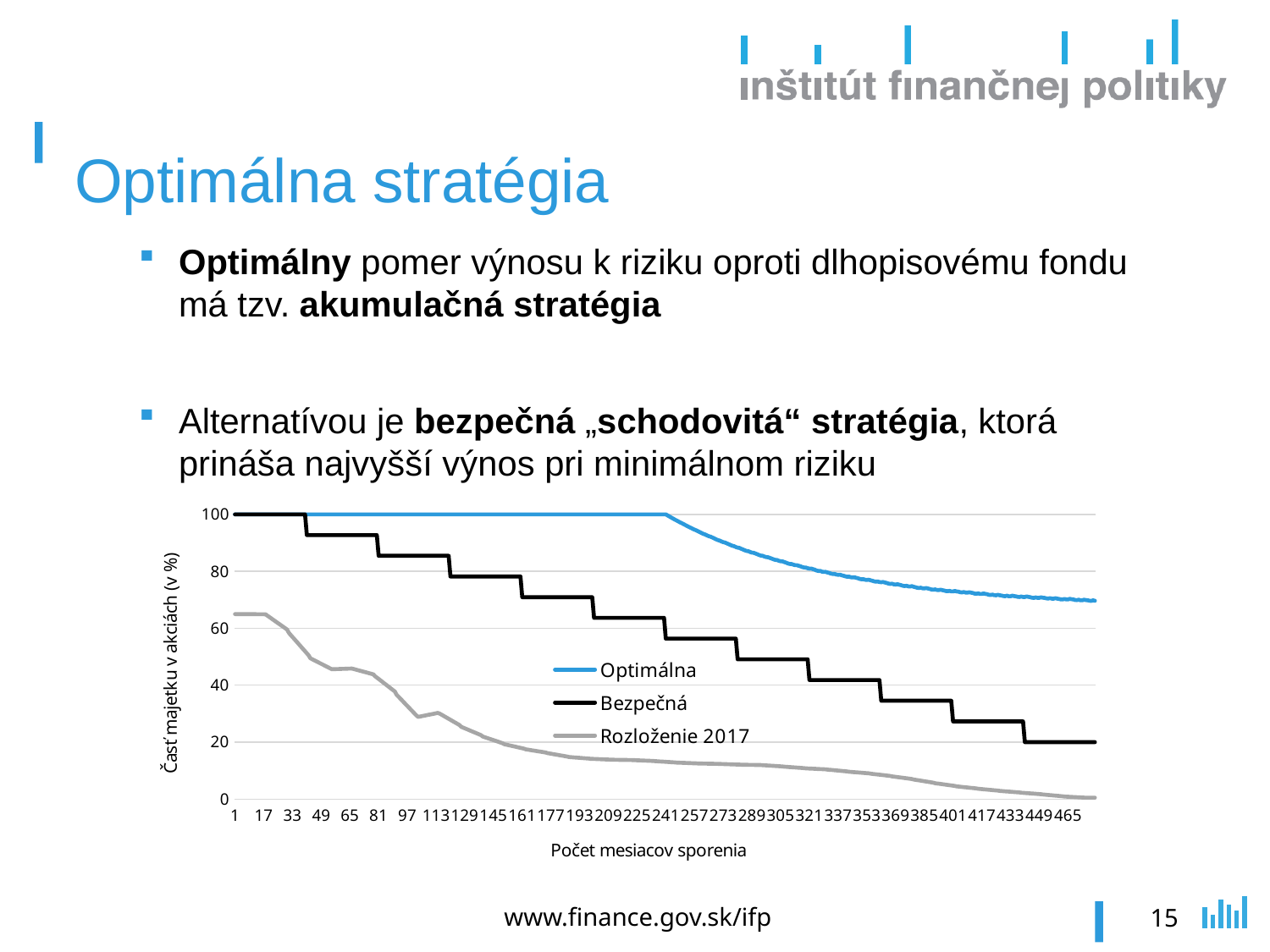
What is the title of the x axis of the chart? Počet mesiacov sporenia How many series does the chart legend list? 3 Is the value of the Bezpečná series at month 241 greater or less than 40? greater What is the value of the Bezpečná series at month 465? 20 What are the three series named in the chart legend? Optimálna, Bezpečná, Rozloženie 2017 Does the Optimálna series rise or fall overall along the x axis? fall Is the value of the Optimálna series at month 465 greater or less than 60? greater Which series has the lowest value at month 465? Rozloženie 2017 What kind of chart is shown on the slide? line chart Is the value of the Rozloženie 2017 series at month 1 greater or less than 80? less What is the value of the Optimálna series at month 1? 100 At month 465, which series has the larger value, Optimálna or Bezpečná? Optimálna